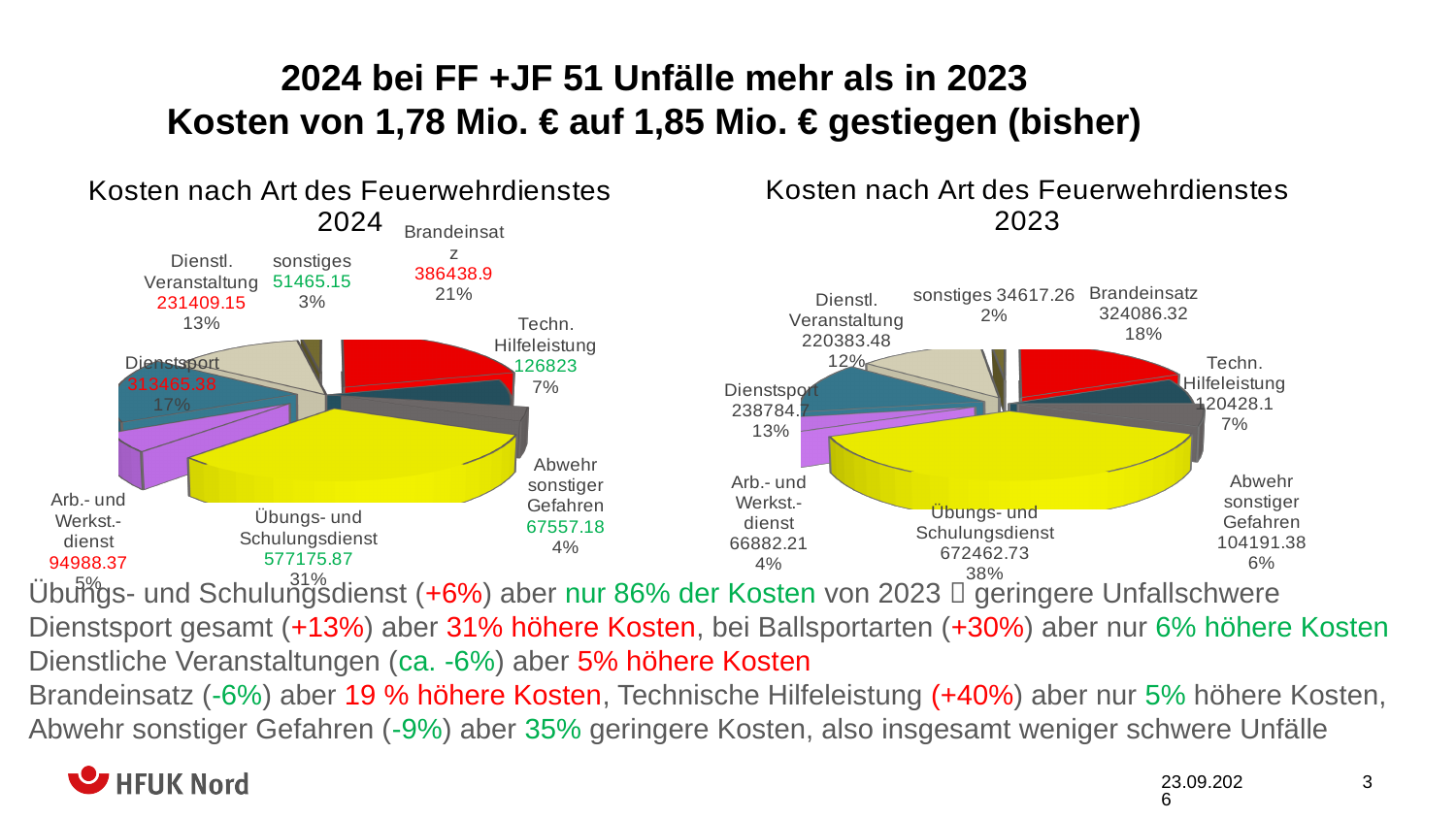
What kind of chart is the 'Kosten nach Art des Feuerwehrdienstes 2024' chart? Pie chart In the 'Kosten nach Art des Feuerwehrdienstes 2023' chart, which category has the lowest cost? sonstiges In the 'Kosten nach Art des Feuerwehrdienstes 2023' chart, what is the value for Abwehr sonstiger Gefahren? 104191.38 In the 'Kosten nach Art des Feuerwehrdienstes 2023' chart, what share of the pie does Übungs- und Schulungsdienst have? 38% In the 'Kosten nach Art des Feuerwehrdienstes 2023' chart, what is the value for Dienstsport? 238784.7 What is the difference between the Brandeinsatz value in the 2024 chart and the Brandeinsatz value in the 2023 chart? 62352.58 In the 'Kosten nach Art des Feuerwehrdienstes 2024' chart, which is larger: Dienstsport or Dienstl. Veranstaltung? Dienstsport In the 'Kosten nach Art des Feuerwehrdienstes 2024' chart, what is the value for Brandeinsatz? 386438.9 How many categories are shown in the 'Kosten nach Art des Feuerwehrdienstes 2024' chart? 8 In the 'Kosten nach Art des Feuerwehrdienstes 2024' chart, what share of the pie does Dienstsport have? 17% What is the difference between the Übungs- und Schulungsdienst value in the 2023 chart and the Übungs- und Schulungsdienst value in the 2024 chart? 95286.86 In the 'Kosten nach Art des Feuerwehrdienstes 2024' chart, which category has the highest cost? Übungs- und Schulungsdienst